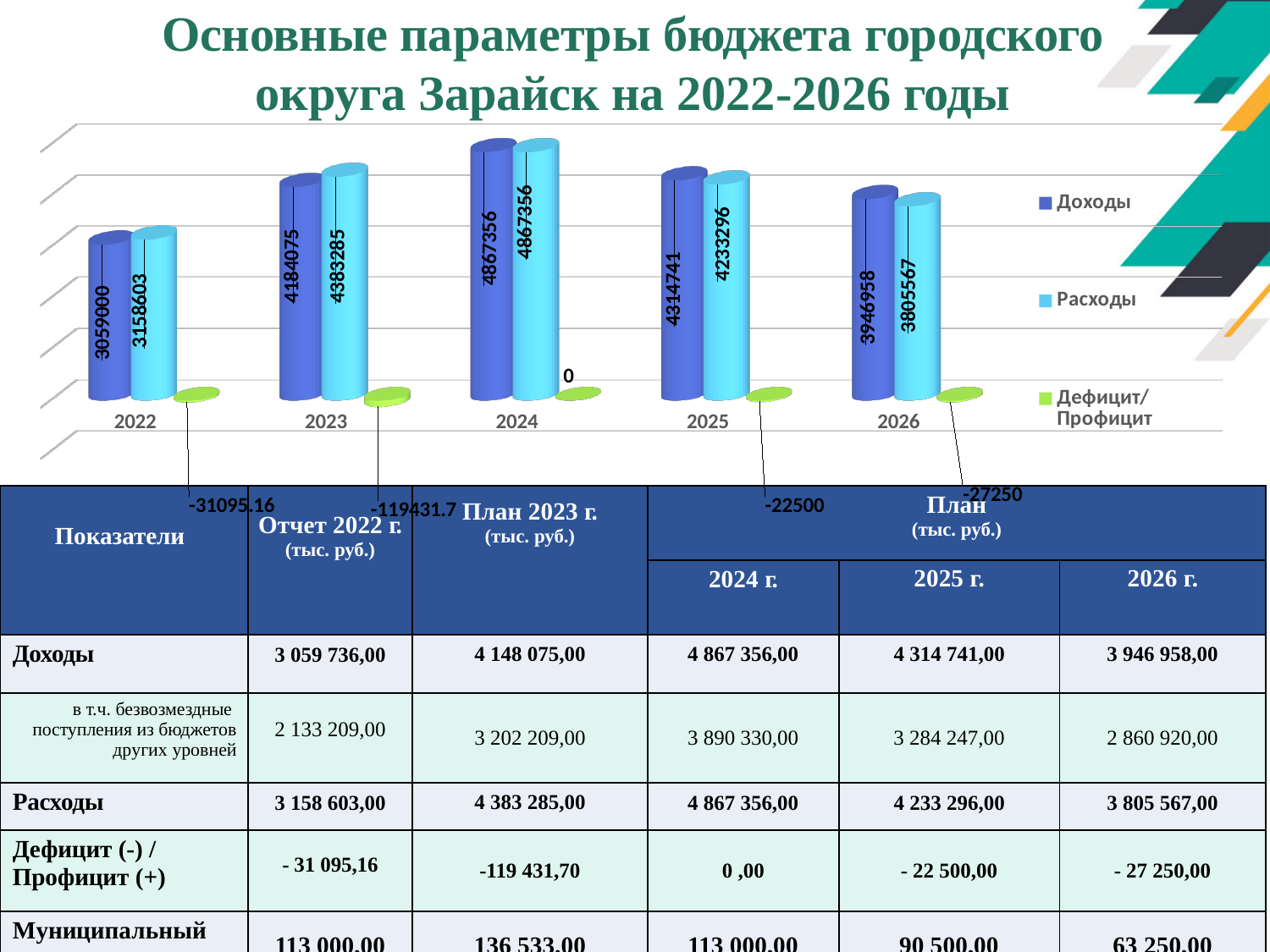
In which year is Расходы lowest in the chart? 2022 For 2025, which is larger in the chart: Доходы or Расходы? Доходы In which year is Доходы highest in the chart? 2024 What is the Дефицит/Профицит value for 2024 in the chart? 0 What is the difference between Доходы and Расходы for 2025 in the chart? 81445 Do the Доходы values rise or fall from 2024 to 2026 in the chart? fall How many series does the chart legend list? 3 What kind of chart is shown on the slide? bar chart What is the Дефицит/Профицит value for 2023 in the chart? -119431.7 What is the value of Доходы for 2024 in the chart? 4867356 How many years are shown on the x axis of the chart? 5 What is the value of Расходы for 2026 in the chart? 3805567